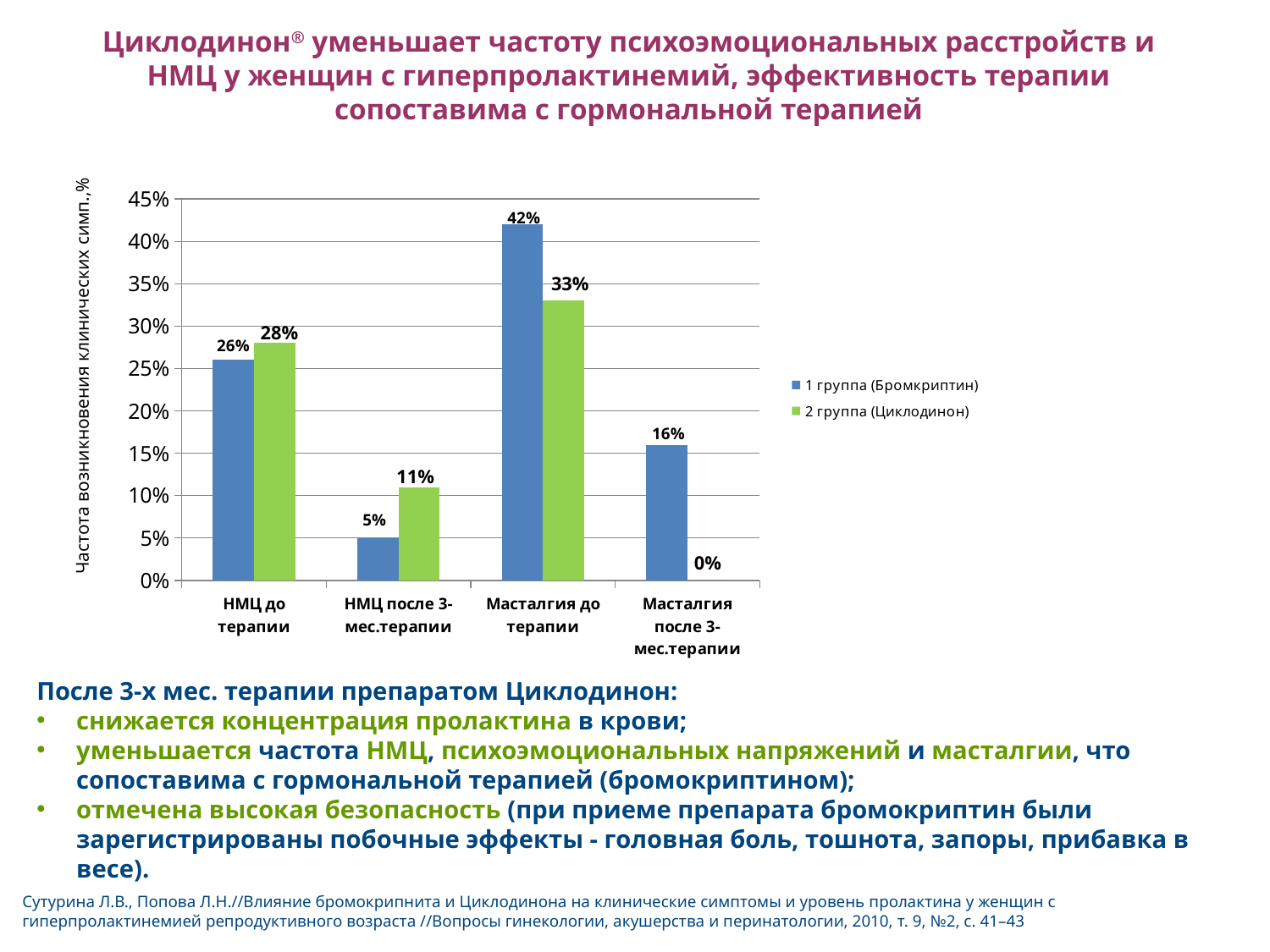
How many series does the legend list? 2 In the category НМЦ после 3-мес.терапии, which series has the larger value? 2 группа (Циклодинон) What is the value for 1 группа (Бромкриптин) in the category НМЦ до терапии? 26% What is the value for 2 группа (Циклодинон) in the category Масталгия после 3-мес.терапии? 0% What is the label of the y axis? Частота возникновения клинических симп.,% Is the value for 1 группа (Бромкриптин) in the category Масталгия до терапии greater or less than 40%? greater What is the value for 2 группа (Циклодинон) in the category Масталгия до терапии? 33% Which category has the highest value for 1 группа (Бромкриптин)? Масталгия до терапии Which category has the lowest value for 2 группа (Циклодинон)? Масталгия после 3-мес.терапии How many categories are shown on the x axis? 4 What type of chart is shown on the slide? Bar chart What is the difference between the 1 группа (Бромкриптин) and 2 группа (Циклодинон) values in the category Масталгия до терапии? 9%